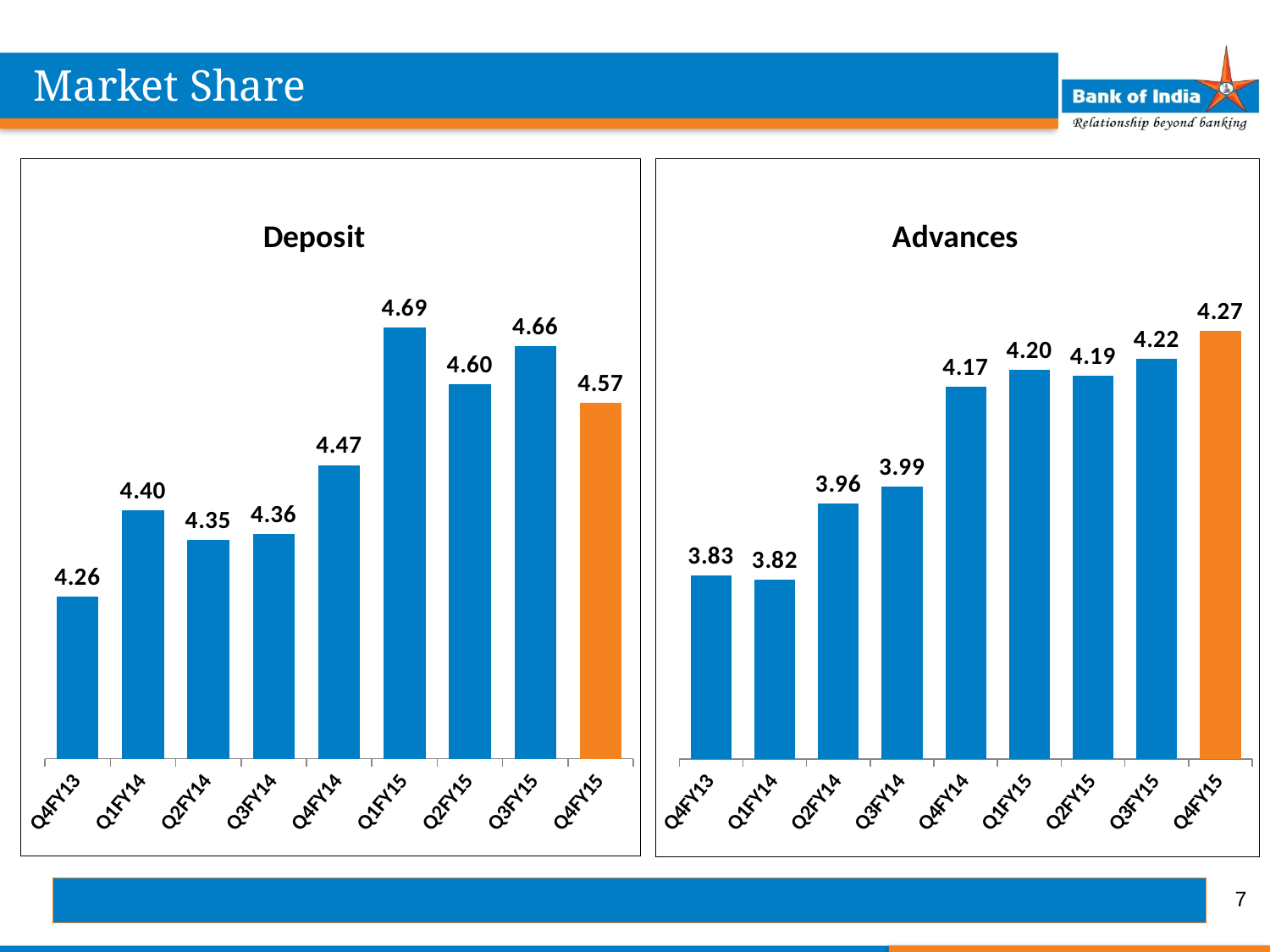
In the Advances chart, which quarter has the lowest value? Q1FY14 In the Deposit chart, what is the difference between the Q1FY15 value and the Q4FY13 value? 0.43 In the Deposit chart, which quarter has the highest value? Q1FY15 In the Advances chart, what is the difference between the Q4FY15 value and the Q3FY15 value? 0.05 In the Deposit chart, which bar is coloured orange rather than blue? Q4FY15 In the Advances chart, do the values generally rise or fall from Q4FY13 to Q4FY15? Rise What kind of chart is the Deposit chart? Bar chart In the Advances chart, what is the value for Q4FY15? 4.27 In the Deposit chart, what is the value for Q1FY15? 4.69 How many quarters are shown in the Advances chart? 9 In the Deposit chart, which is larger, the value for Q2FY15 or the value for Q4FY15? Q2FY15 In the Advances chart, which is larger, the value for Q1FY15 or the value for Q4FY14? Q1FY15